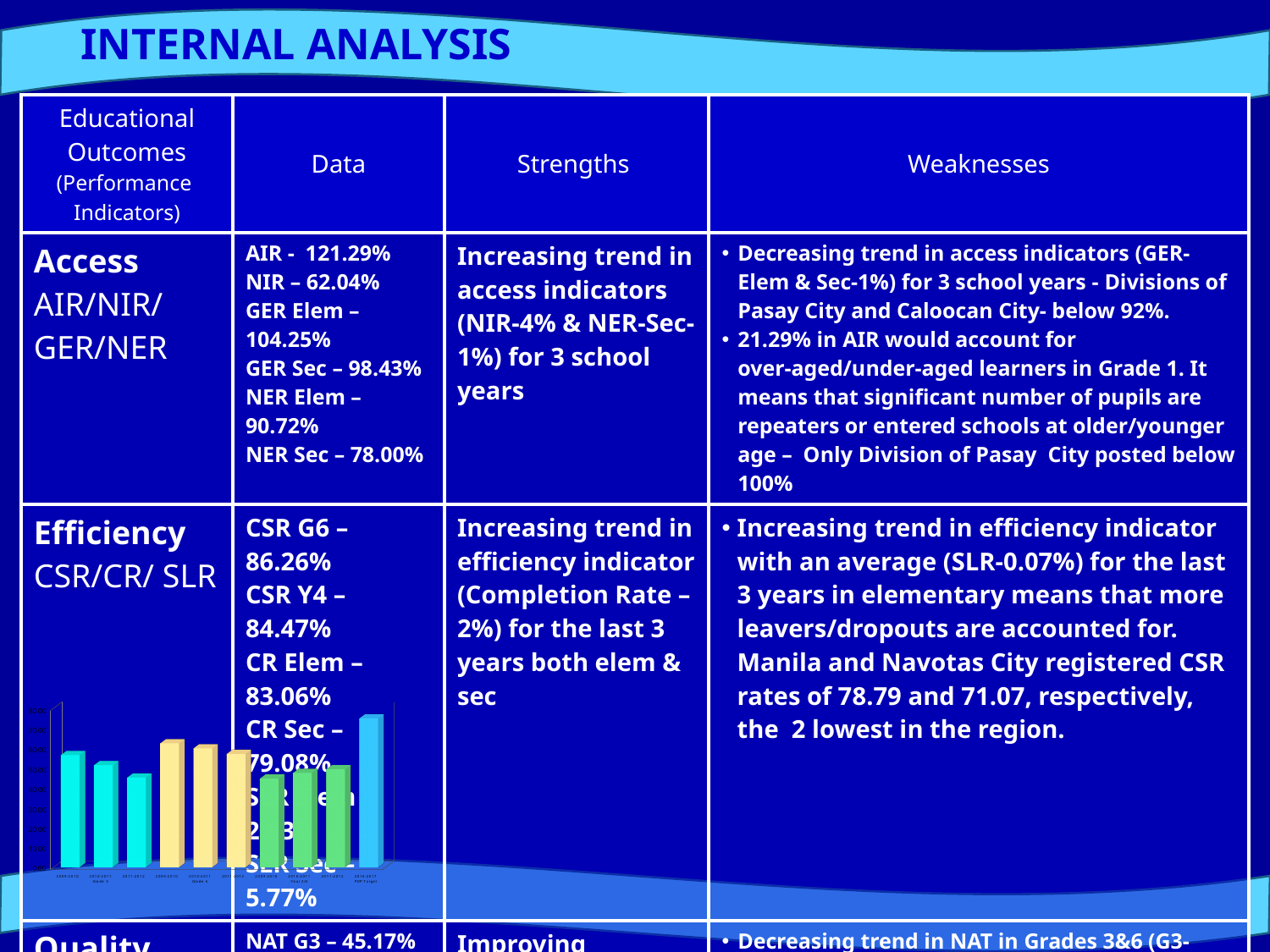
In the bar chart at the bottom left, do the first three cyan bars rise or fall from left to right? fall What kind of chart is shown at the bottom left of the slide? bar chart In the bar chart at the bottom left, which is taller: the blue bar on the far right or the first yellow bar? the blue bar on the far right In the bar chart at the bottom left, which bar is the tallest? the blue bar on the far right How many different bar colours are used in the bar chart at the bottom left? 4 In the bar chart at the bottom left, which is taller: the first cyan bar or the third cyan bar? the first cyan bar